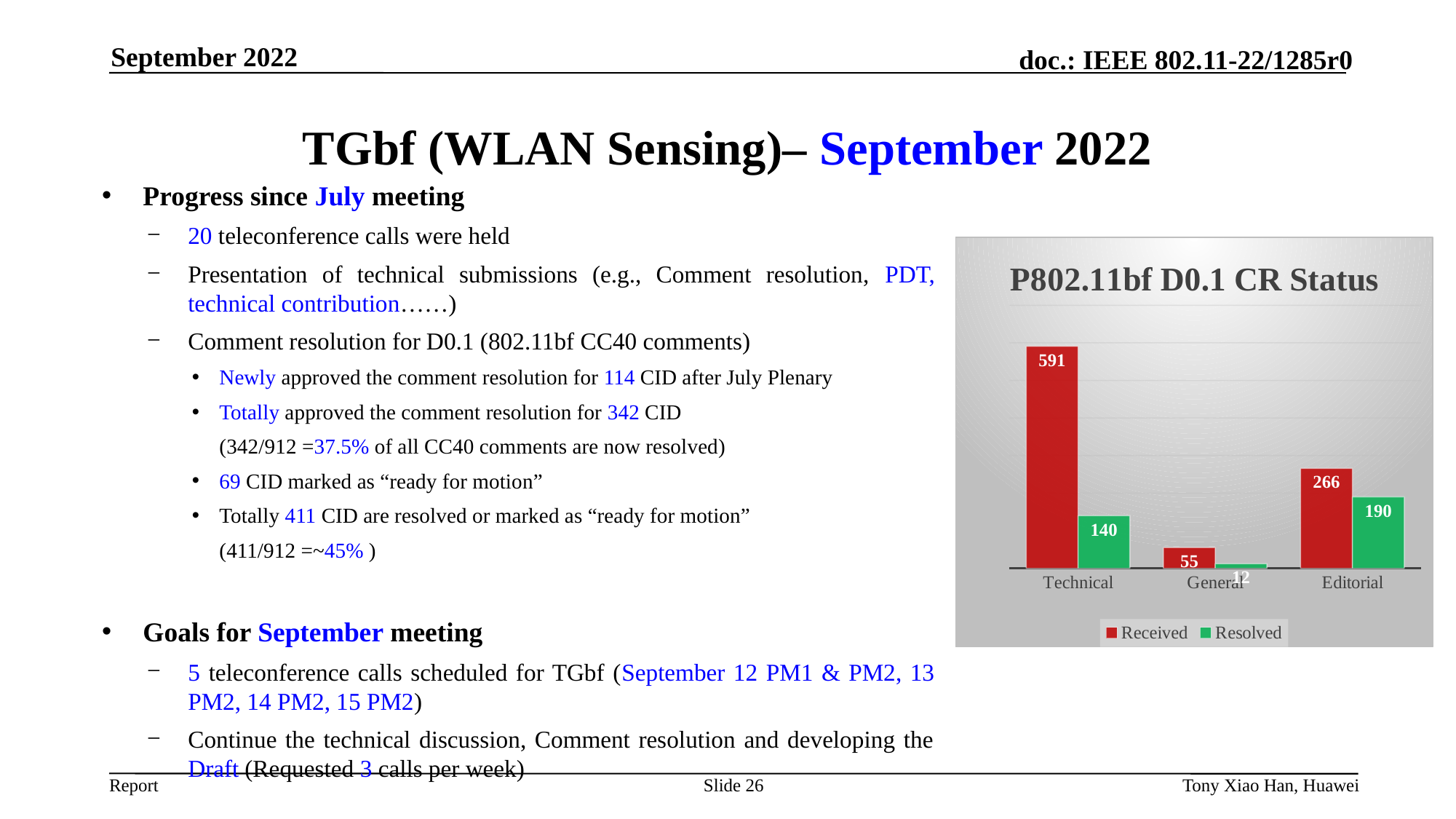
What is the difference between Received and Resolved for Editorial? 76 What is the difference between Received and Resolved for Technical? 451 What is the Resolved value for General? 12 Which category has the lowest Resolved value? General What is the title of the chart? P802.11bf D0.1 CR Status Which category has the highest Received value? Technical Which is larger: the Resolved value for Editorial or the Resolved value for Technical? Editorial How many series does the legend list? 2 What is the Received value for Technical? 591 What is the Received value for General? 55 What is the Resolved value for Editorial? 190 How many categories are shown on the x axis? 3